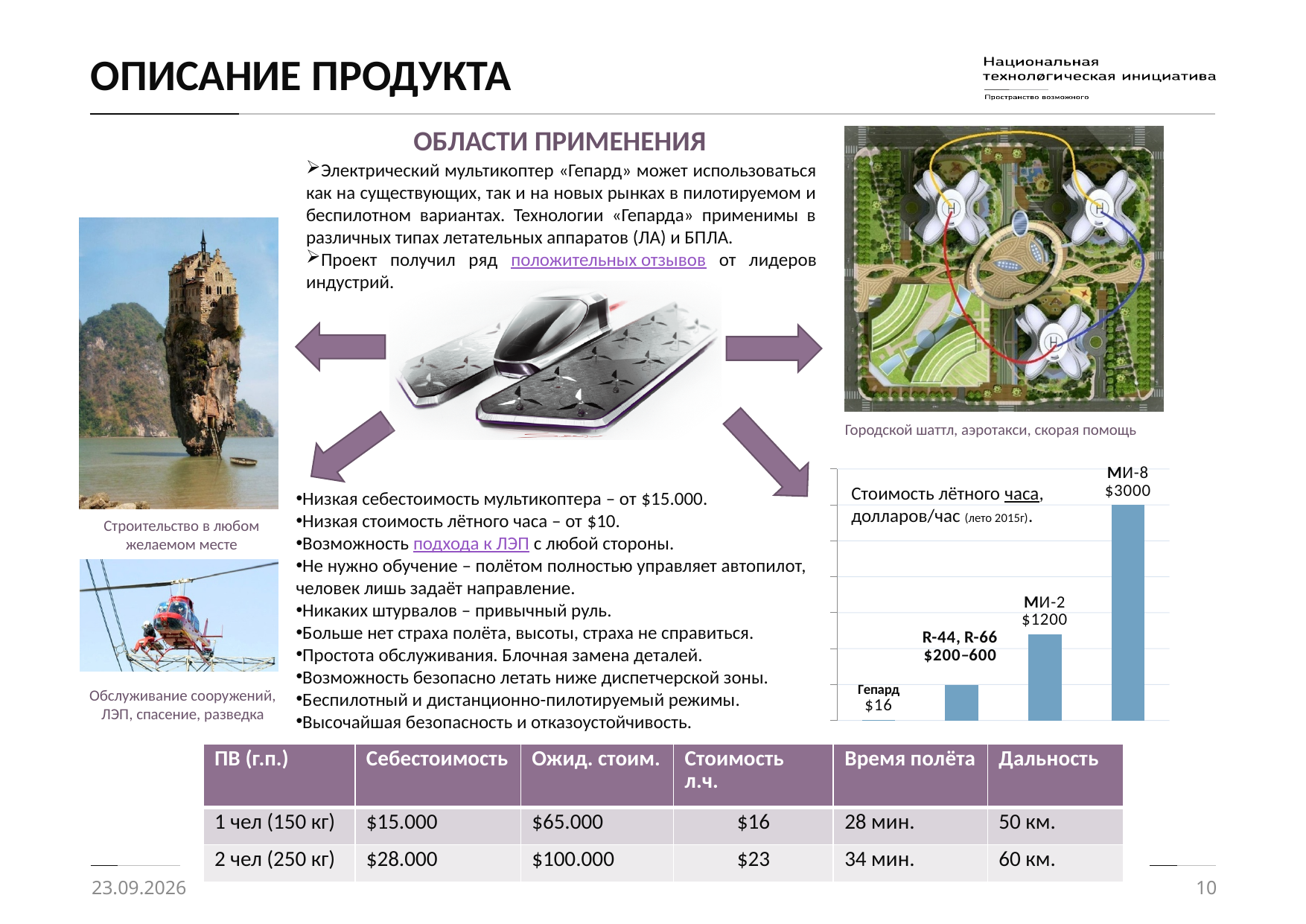
What is the flight-hour cost shown for МИ-8 in the chart? $3000 What flight-hour cost range is labelled for R-44, R-66 in the chart? $200–600 How many aircraft categories are shown in the chart? 4 Which aircraft has the highest flight-hour cost in the chart? МИ-8 What unit does the chart title say the flight-hour cost is measured in? долларов/час Do the bar values rise or fall from left to right in the chart? Rise What type of chart is used to show the flight-hour costs? Bar chart Which has a higher flight-hour cost in the chart, МИ-2 or Гепард? МИ-2 What is the flight-hour cost shown for Гепард in the chart? $16 What is the flight-hour cost shown for МИ-2 in the chart? $1200 Which aircraft has the lowest flight-hour cost in the chart? Гепард What is the difference between the flight-hour cost of МИ-8 and МИ-2 in the chart? $1800